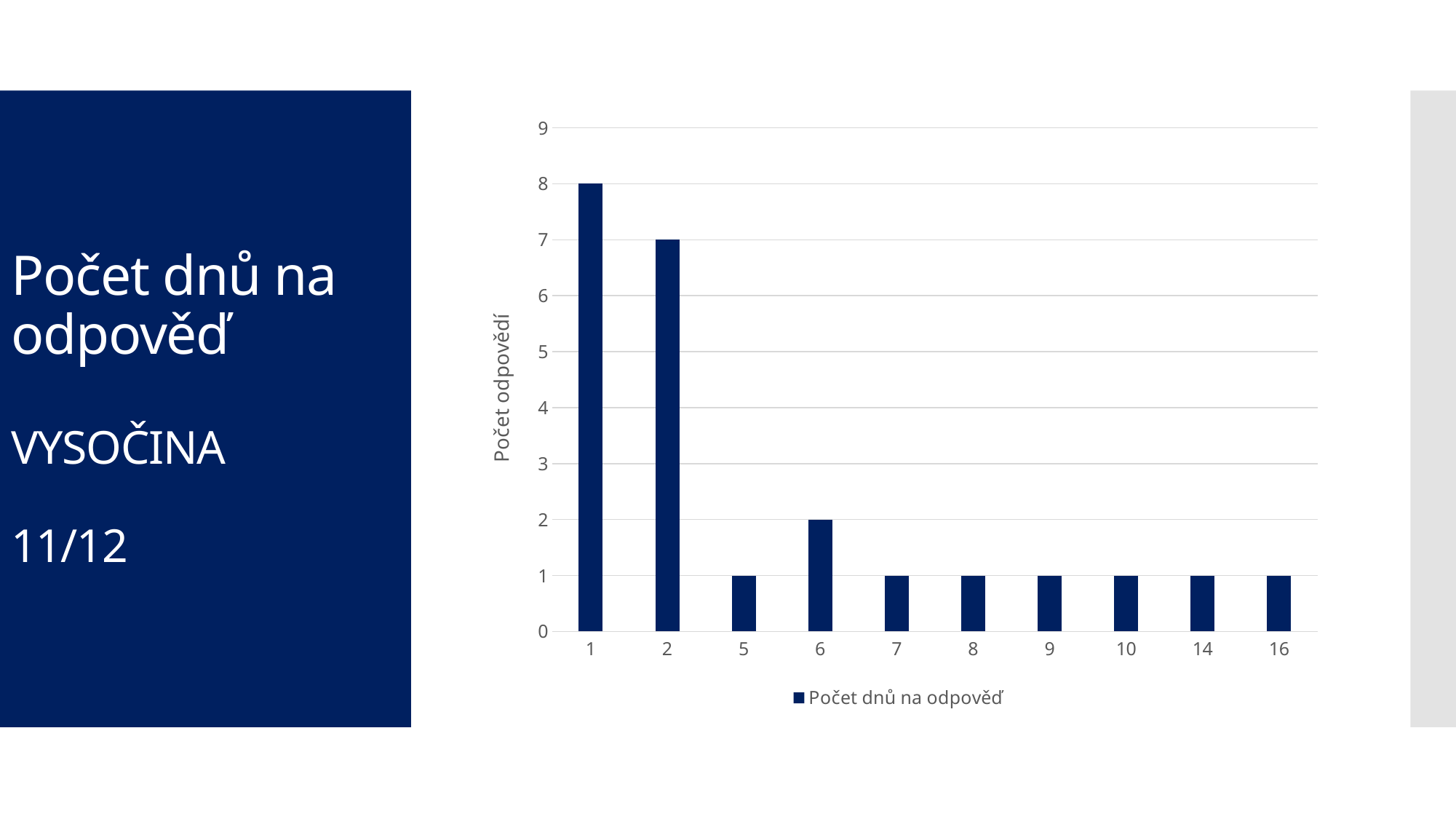
What is the value for category 2 in the chart? 7 What is the label of the y axis of the chart? Počet odpovědí How many series does the chart legend list? 1 What type of chart is shown on the slide? bar chart Which is larger, the value for category 6 or the value for category 7? 6 What is the difference between the values for category 1 and category 2? 1 Is the value for category 2 greater or less than 5? greater What is the value for category 1 in the chart? 8 What is the value for category 6 in the chart? 2 Which category has the highest value in the chart? 1 What is the value for category 14 in the chart? 1 How many categories are shown on the x axis of the chart? 10